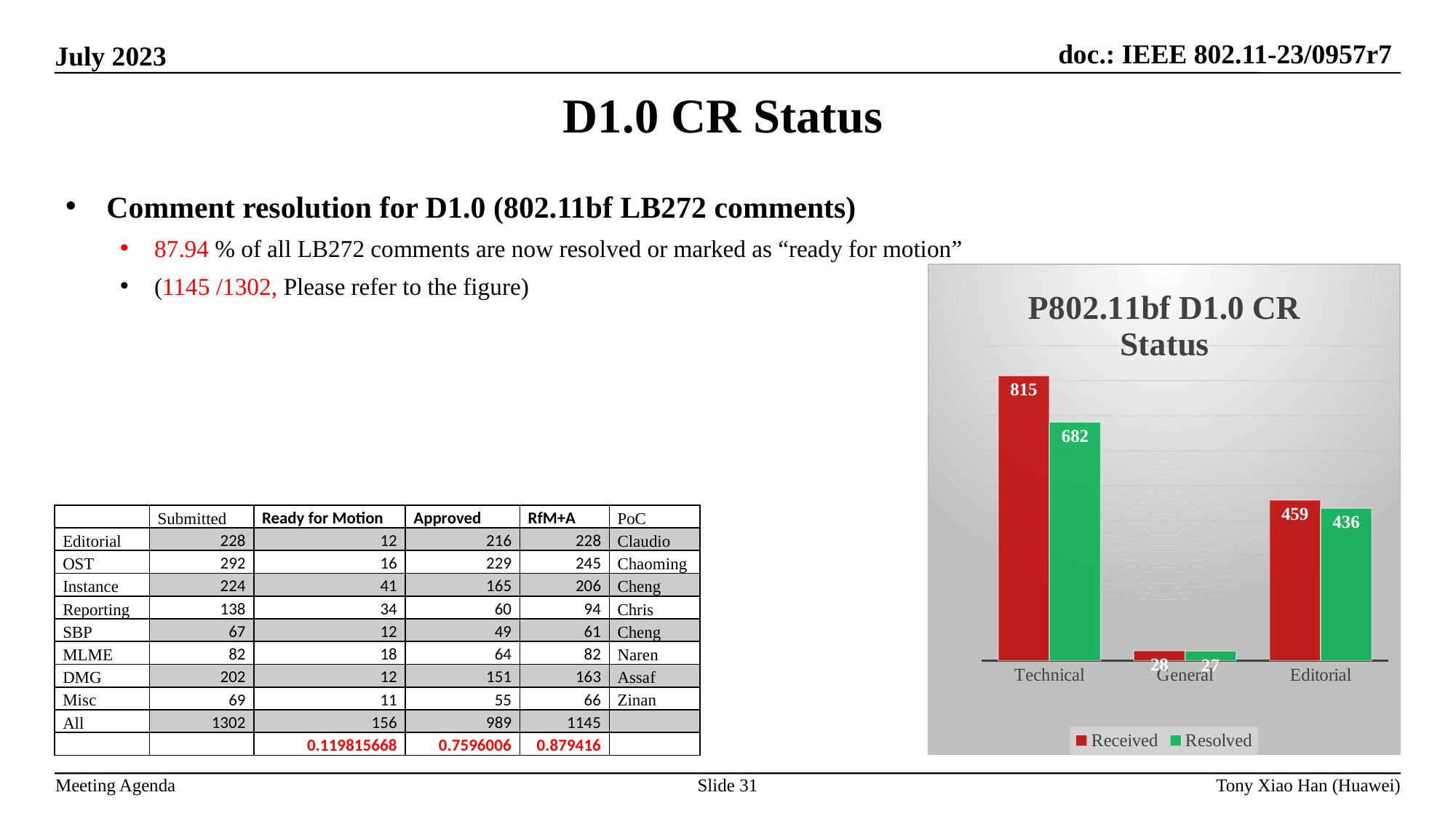
What is the Received value for Technical? 815 Which category has the highest Received value? Technical What is the Resolved value for Editorial? 436 Which category has the lowest Resolved value? General How many series does the chart legend list? 2 What is the difference between the Received and Resolved values for Editorial? 23 Which is larger, the Received value for Editorial or the Resolved value for Technical? Resolved value for Technical What is the difference between the Received and Resolved values for Technical? 133 How many categories are shown on the x axis of the chart? 3 What is the Resolved value for Technical? 682 What is the Received value for General? 28 What type of chart is shown on the slide? Bar chart